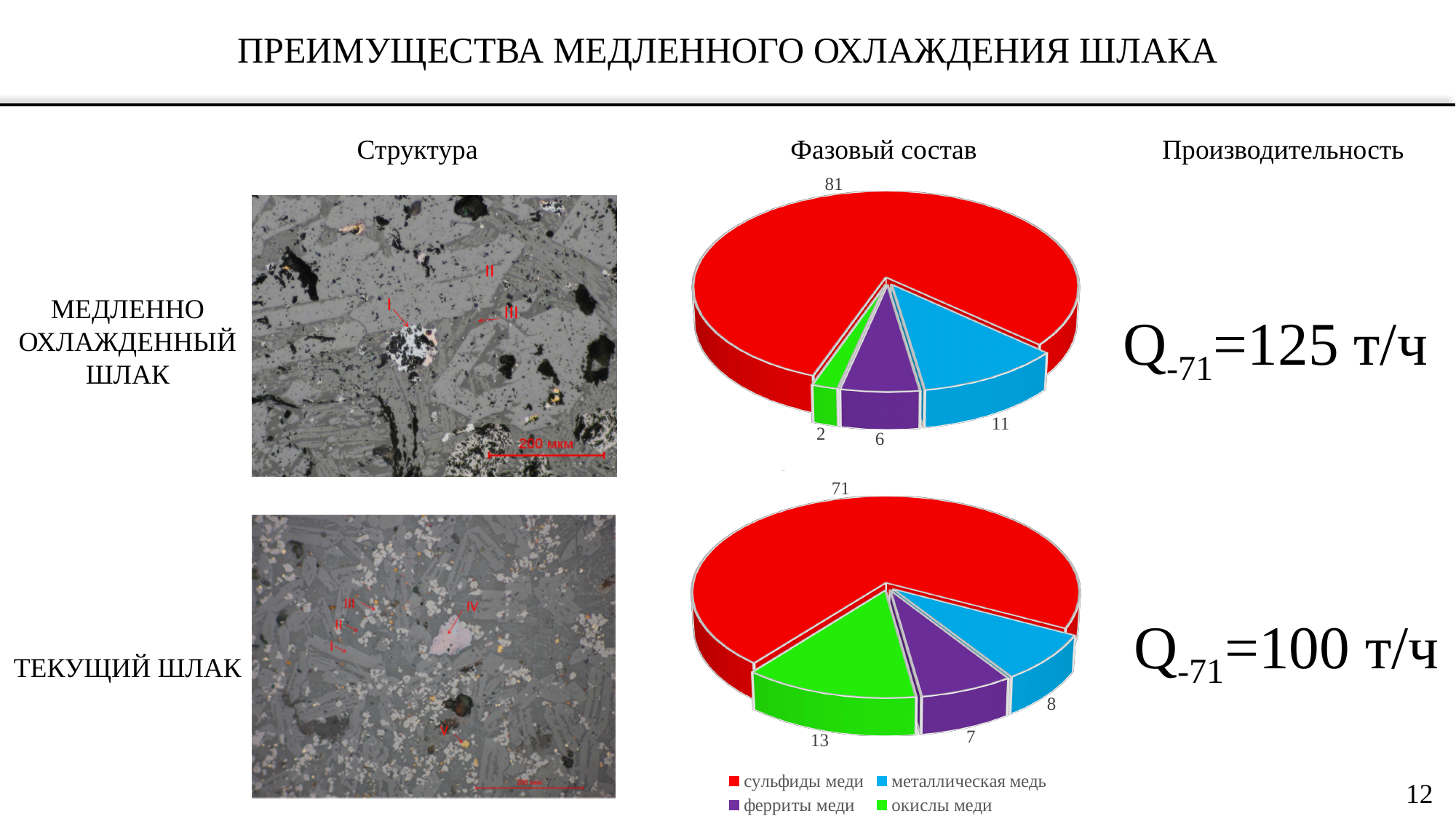
In the bottom pie chart (текущий шлак), what is the value for окислы меди? 13 What type of chart is used to show the фазовый состав? pie chart In the bottom pie chart (текущий шлак), which category has the largest slice? сульфиды меди In the bottom pie chart (текущий шлак), which is larger: окислы меди or металлическая медь? окислы меди In the legend below the pie charts, which colour represents ферриты меди? purple How many slices does the top pie chart (медленно охлажденный шлак) have? 4 In the top pie chart (медленно охлажденный шлак), what is the value for металлическая медь? 11 In the top pie chart (медленно охлажденный шлак), which category has the smallest slice? окислы меди In the bottom pie chart (текущий шлак), what is the value for ферриты меди? 7 In the top pie chart (медленно охлажденный шлак), what is the value for сульфиды меди? 81 What is the difference between the сульфиды меди values in the top pie chart (81) and the bottom pie chart (71)? 10 How many entries does the legend below the pie charts list? 4